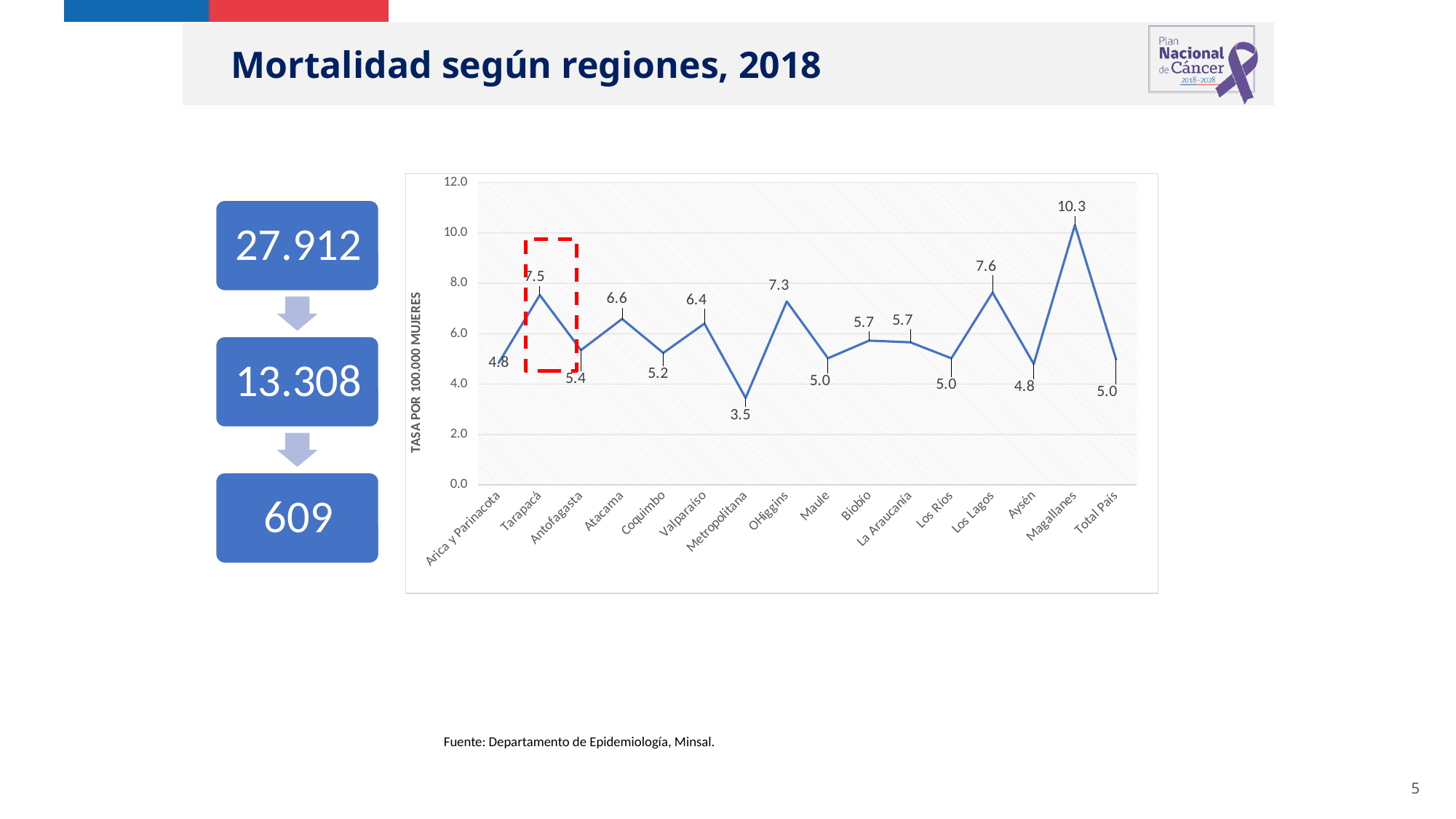
What is the value for Metropolitana? 3.5 Which region has the highest value? Magallanes Which category is highlighted with a red dashed box? Tarapacá What is the difference between the values for Magallanes and Metropolitana? 6.8 Which region has the lowest value? Metropolitana What is the value for Magallanes? 10.3 What is the value for Total País? 5.0 What kind of chart is shown? Line chart What is the label of the vertical axis? TASA POR 100.000 MUJERES What is the value for Tarapacá? 7.5 How many categories are plotted on the x axis? 16 Which is larger, the value for Los Lagos or the value for O'Higgins? Los Lagos